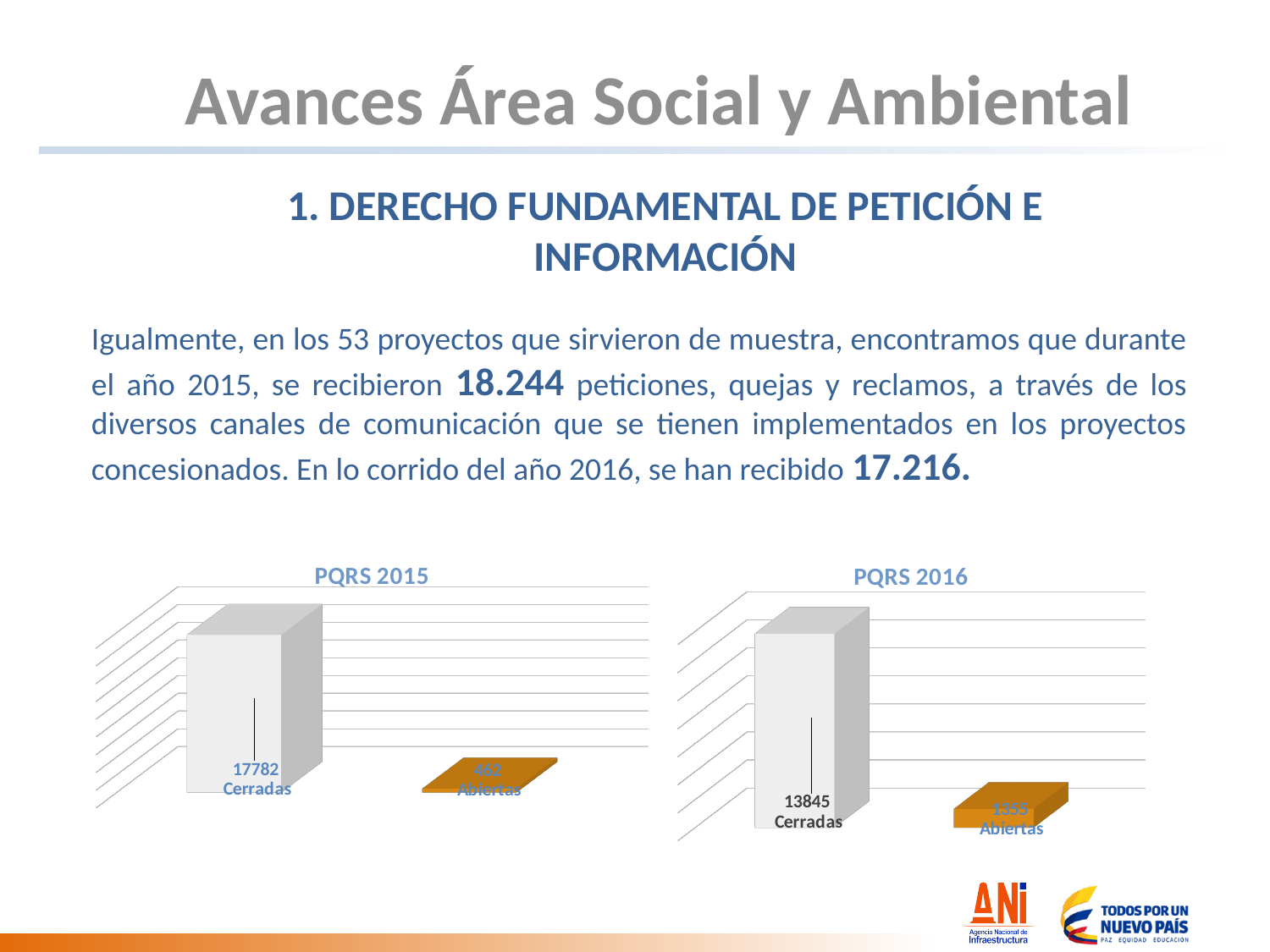
Is the Cerradas value larger in the PQRS 2015 chart or in the PQRS 2016 chart? PQRS 2015 What is the title of the chart on the right side of the slide? PQRS 2016 In the PQRS 2015 chart, which category has the highest value? Cerradas What kind of chart is the PQRS 2015 chart? Bar chart In the PQRS 2015 chart, what is the value for Abiertas? 462 In the PQRS 2016 chart, what is the value for Cerradas? 13845 In the PQRS 2016 chart, what is the difference between Cerradas and Abiertas? 12490 In the PQRS 2015 chart, what is the difference between Cerradas and Abiertas? 17320 In the PQRS 2016 chart, which category has the lowest value? Abiertas In the PQRS 2015 chart, what is the value for Cerradas? 17782 In the PQRS 2016 chart, what is the value for Abiertas? 1355 How many categories are shown in the PQRS 2016 chart? 2